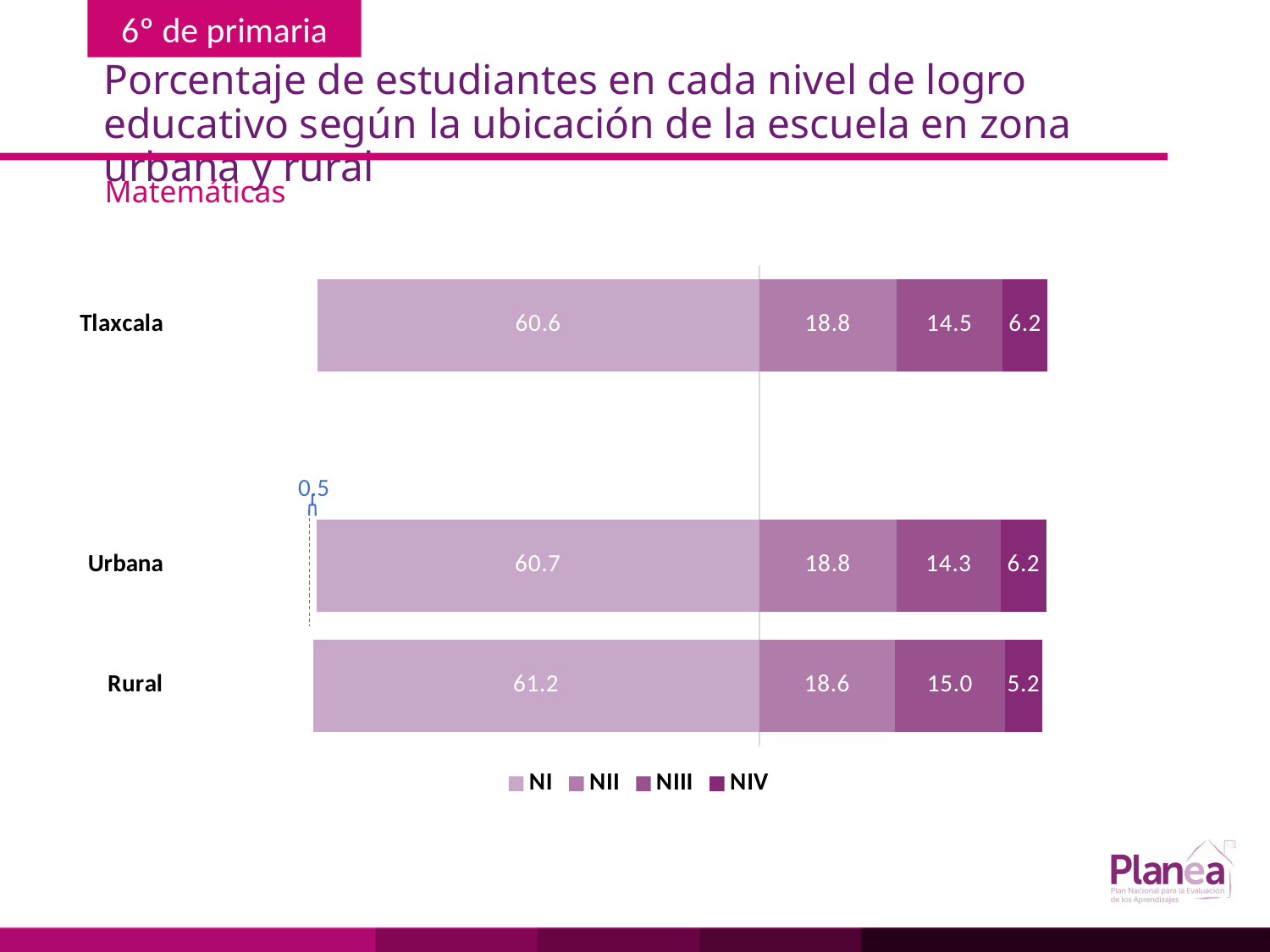
Which is larger, the NIII value for Tlaxcala or the NIII value for Urbana? Tlaxcala How many categories are plotted on the chart? 3 How many series does the legend list? 4 What is the NI value for Tlaxcala? 60.6 What is the NIII value for Rural? 15.0 What is the NII value for Rural? 18.6 Which category has the lowest NIV value? Rural What is the difference between the NI values for Rural and Tlaxcala? 0.6 What kind of chart is shown on the slide? stacked bar chart What is the NIV value for Urbana? 6.2 Which category has the highest NI value? Rural What is the total of the stacked bar for Urbana? 100.0